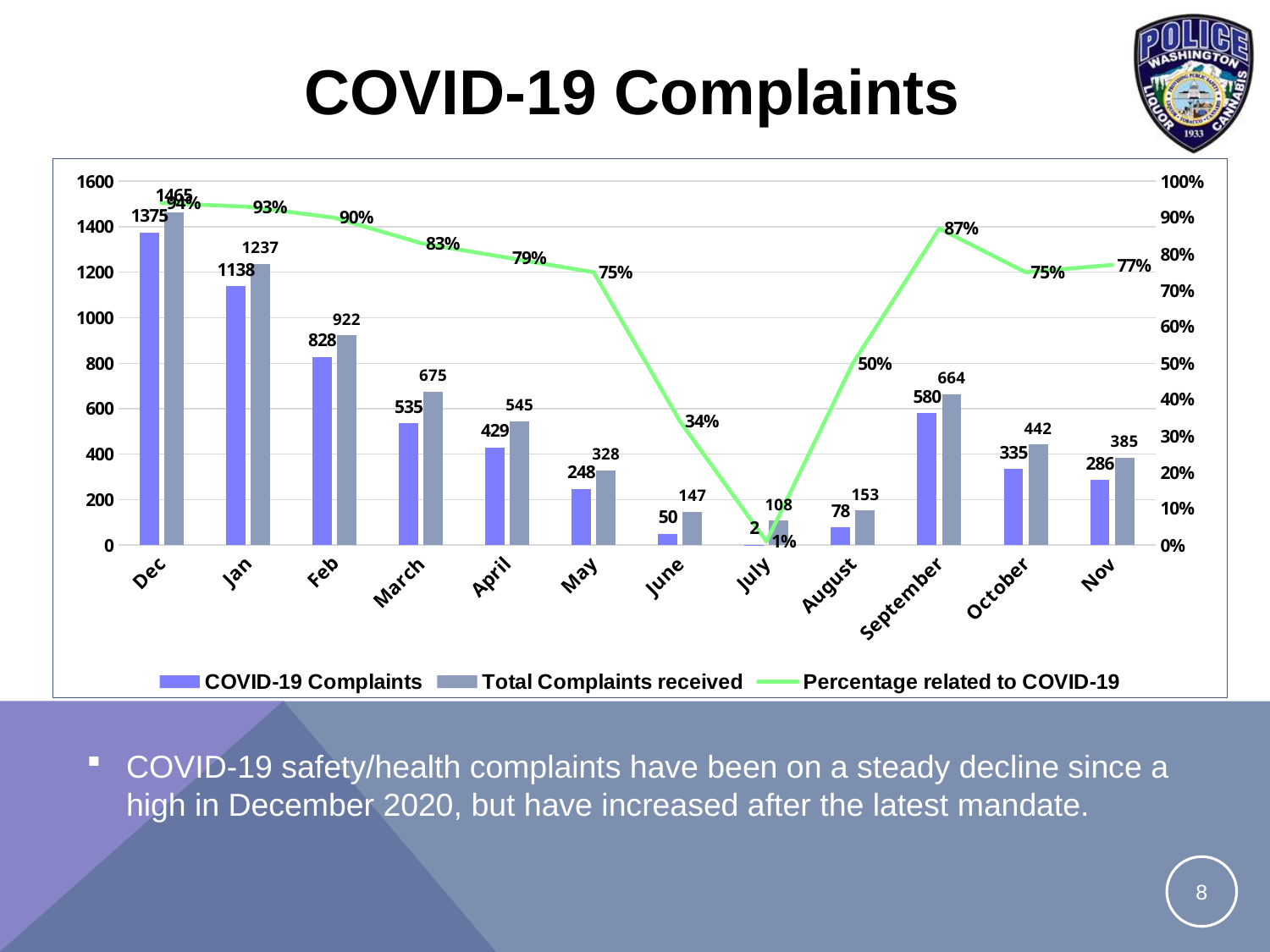
What is the difference between Total Complaints received and COVID-19 Complaints in March? 140 Which month has the lowest value for COVID-19 Complaints? July What is the value of Total Complaints received for September? 664 What is the title of the slide containing the chart? COVID-19 Complaints What is the Percentage related to COVID-19 for May? 75% What is the value of COVID-19 Complaints for Dec? 1375 Which month has the highest value for Total Complaints received? Dec How many series does the legend list? 3 Does the Percentage related to COVID-19 rise or fall from Dec to July? Fall What kind of chart is this? Combined bar and line chart How many months are shown on the x axis? 12 Which is larger: COVID-19 Complaints in September or COVID-19 Complaints in October? September